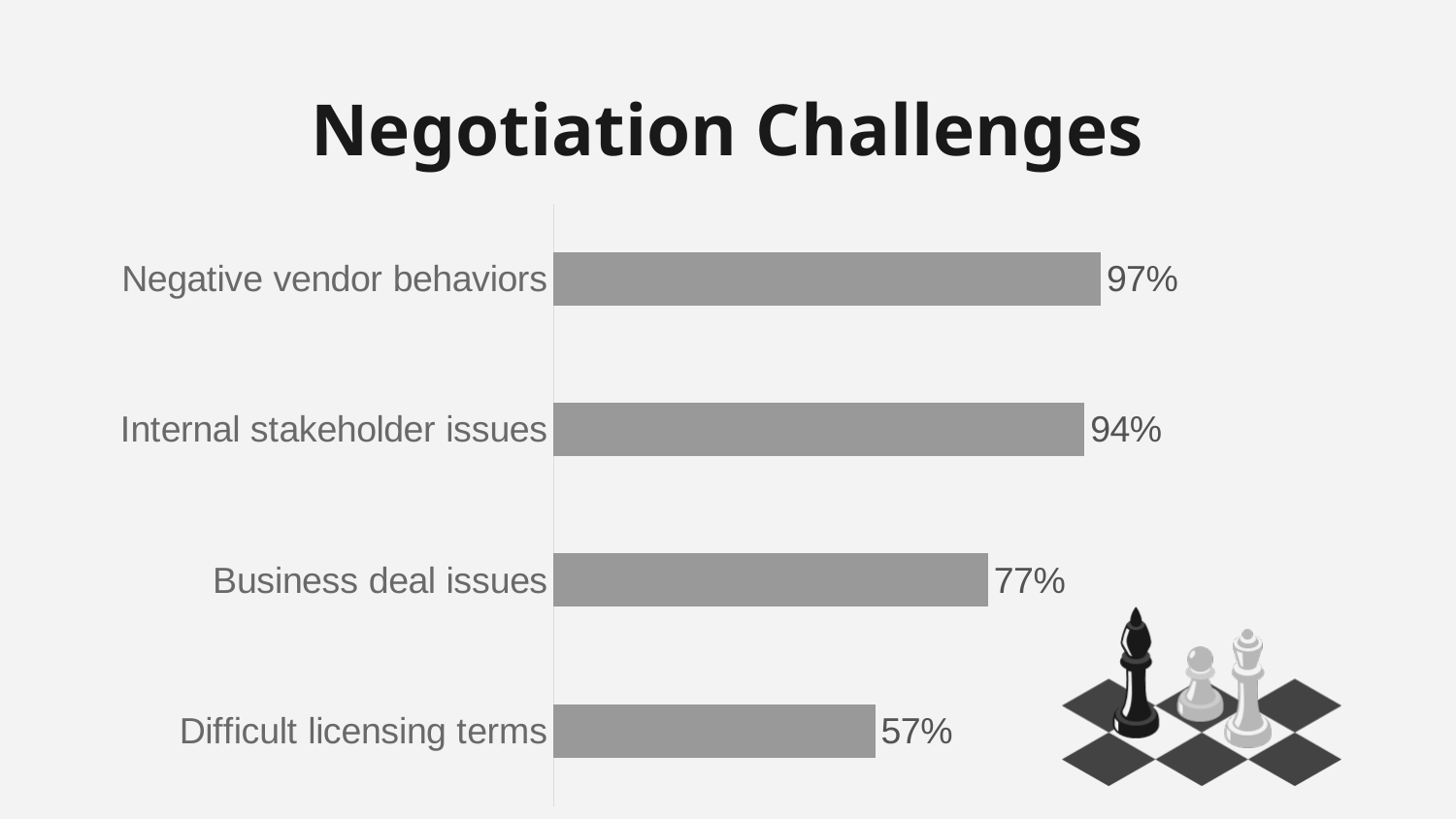
Which category has the highest value? Negative vendor behaviors What is the difference between the values for Negative vendor behaviors and Difficult licensing terms? 40% Which is larger, the value for Business deal issues or the value for Difficult licensing terms? Business deal issues What is the difference between the values for Internal stakeholder issues and Business deal issues? 17% What is the title of the chart? Negotiation Challenges What kind of chart is shown on the slide? Bar chart What is the value for Internal stakeholder issues? 94% How many categories are shown in the chart? 4 What is the value for Negative vendor behaviors? 97% What is the value for Difficult licensing terms? 57% Which category has the lowest value? Difficult licensing terms What is the value for Business deal issues? 77%